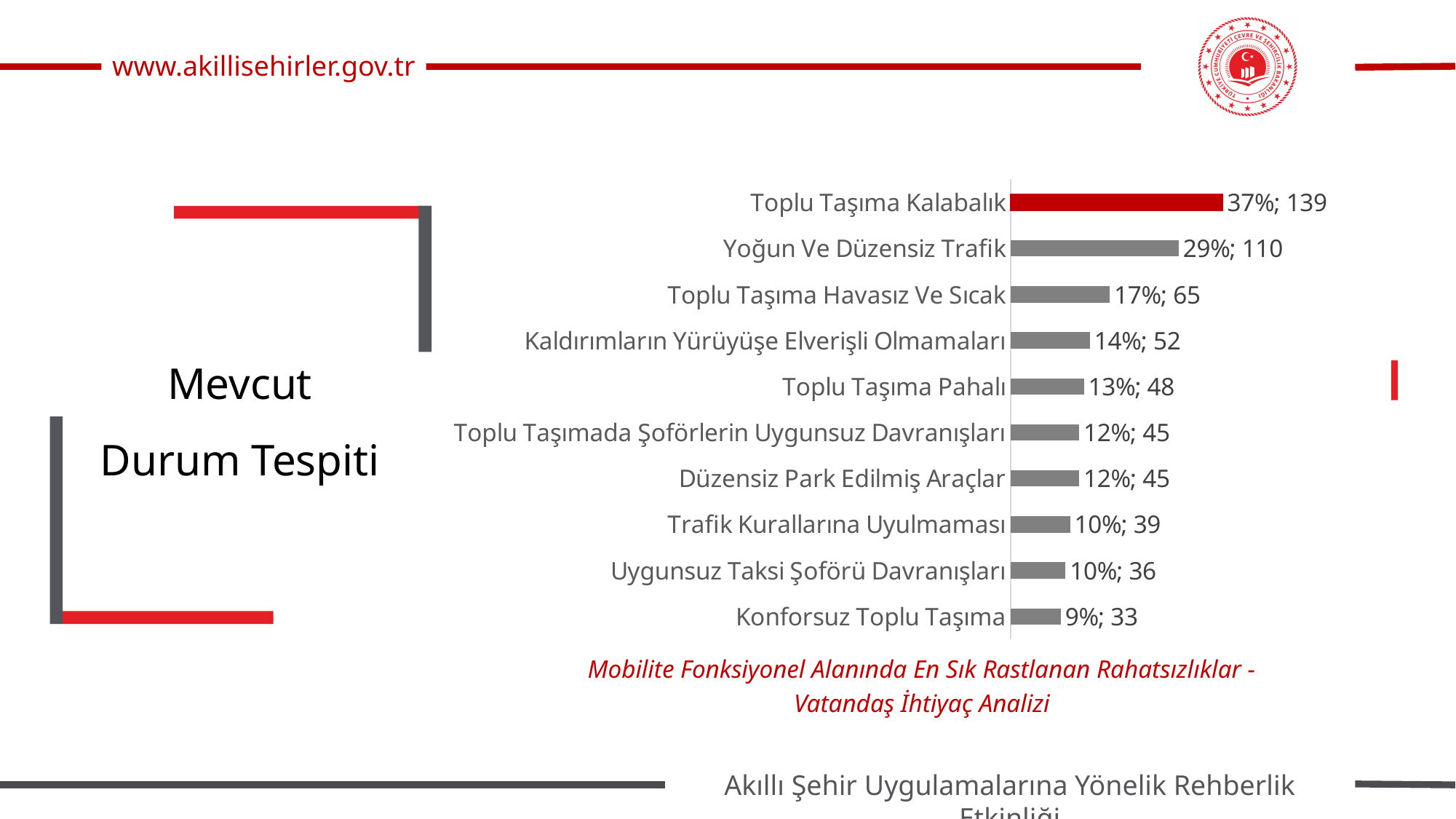
Which category has the highest value? Toplu Taşıma Kalabalık What is the title of the chart shown in red italic text below the bars? Mobilite Fonksiyonel Alanında En Sık Rastlanan Rahatsızlıklar - Vatandaş İhtiyaç Analizi What kind of chart is shown on the slide? Bar chart What is the difference in count between Trafik Kurallarına Uyulmaması and Uygunsuz Taksi Şoförü Davranışları? 3 Which category has the lowest value? Konforsuz Toplu Taşıma How many categories are shown in the chart? 10 What is the data label shown for Toplu Taşıma Kalabalık? 37%; 139 What count is shown for Konforsuz Toplu Taşıma? 33 What is the difference in count between Toplu Taşıma Kalabalık and Yoğun Ve Düzensiz Trafik? 29 Which has a larger count, Kaldırımların Yürüyüşe Elverişli Olmamaları or Toplu Taşıma Pahalı? Kaldırımların Yürüyüşe Elverişli Olmamaları What count is shown for Yoğun Ve Düzensiz Trafik? 110 What percentage is shown for Toplu Taşıma Havasız Ve Sıcak? 17%